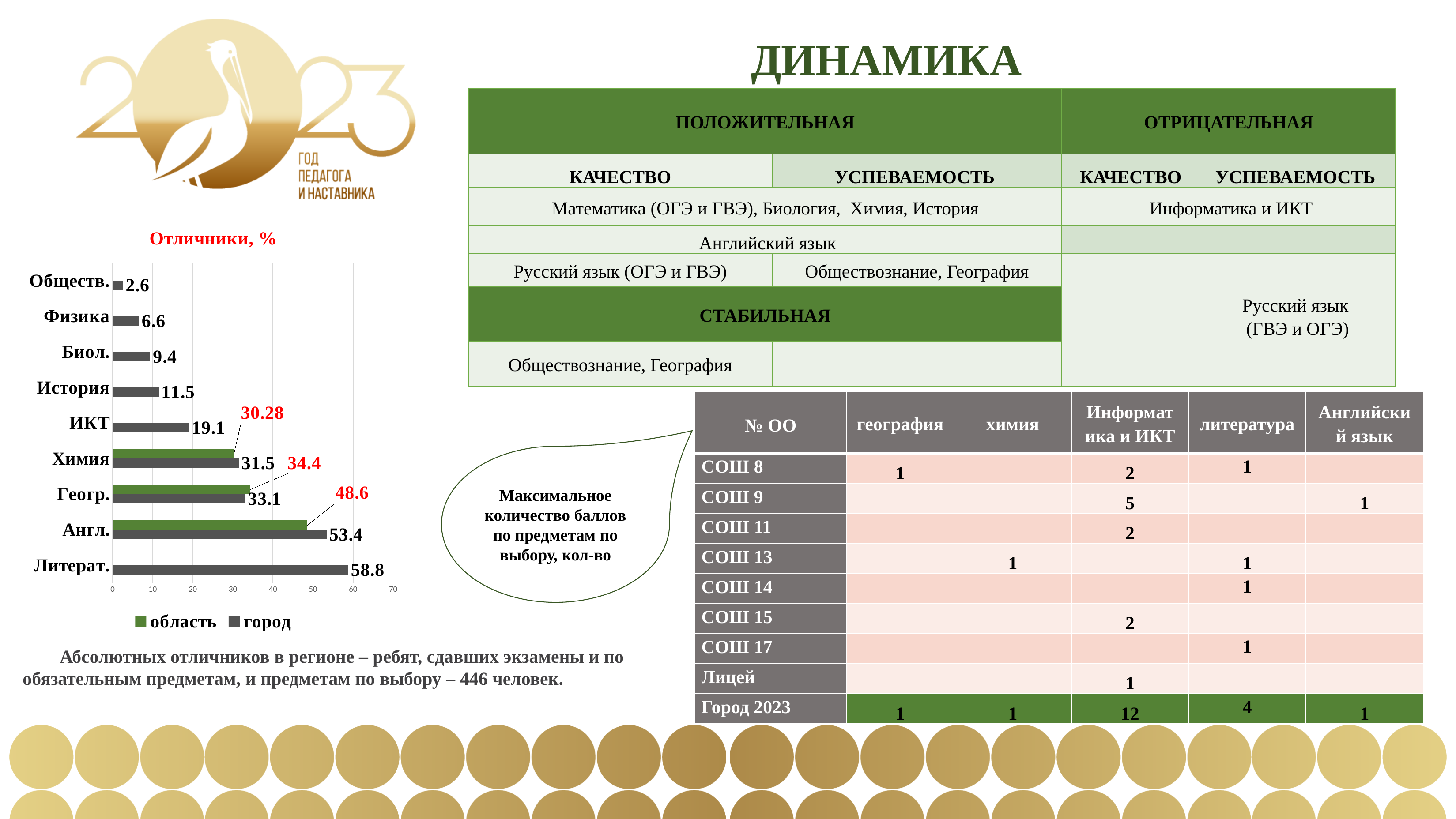
In the "Отличники, %" chart, what is the value for "область" for Англ.? 48.6 In the "Отличники, %" chart, which category has the highest "город" value? Литерат. How many series does the legend of the "Отличники, %" chart list? 2 In the "Отличники, %" chart, what is the value for "область" for Химия? 30.28 In the "Отличники, %" chart, which is larger for Геогр.: the "область" value or the "город" value? область In the "Отличники, %" chart, what is the value for "город" for Литерат.? 58.8 In the "Отличники, %" chart, which category has the lowest "город" value? Обществ. In the "Отличники, %" chart, what colour are the "область" bars? green In the "Отличники, %" chart, what is the difference between the "город" and "область" values for Англ.? 4.8 In the "Отличники, %" chart, what is the value for "город" for ИКТ? 19.1 What type of chart is shown under the title "Отличники, %"? bar chart How many categories are shown in the "Отличники, %" chart? 9